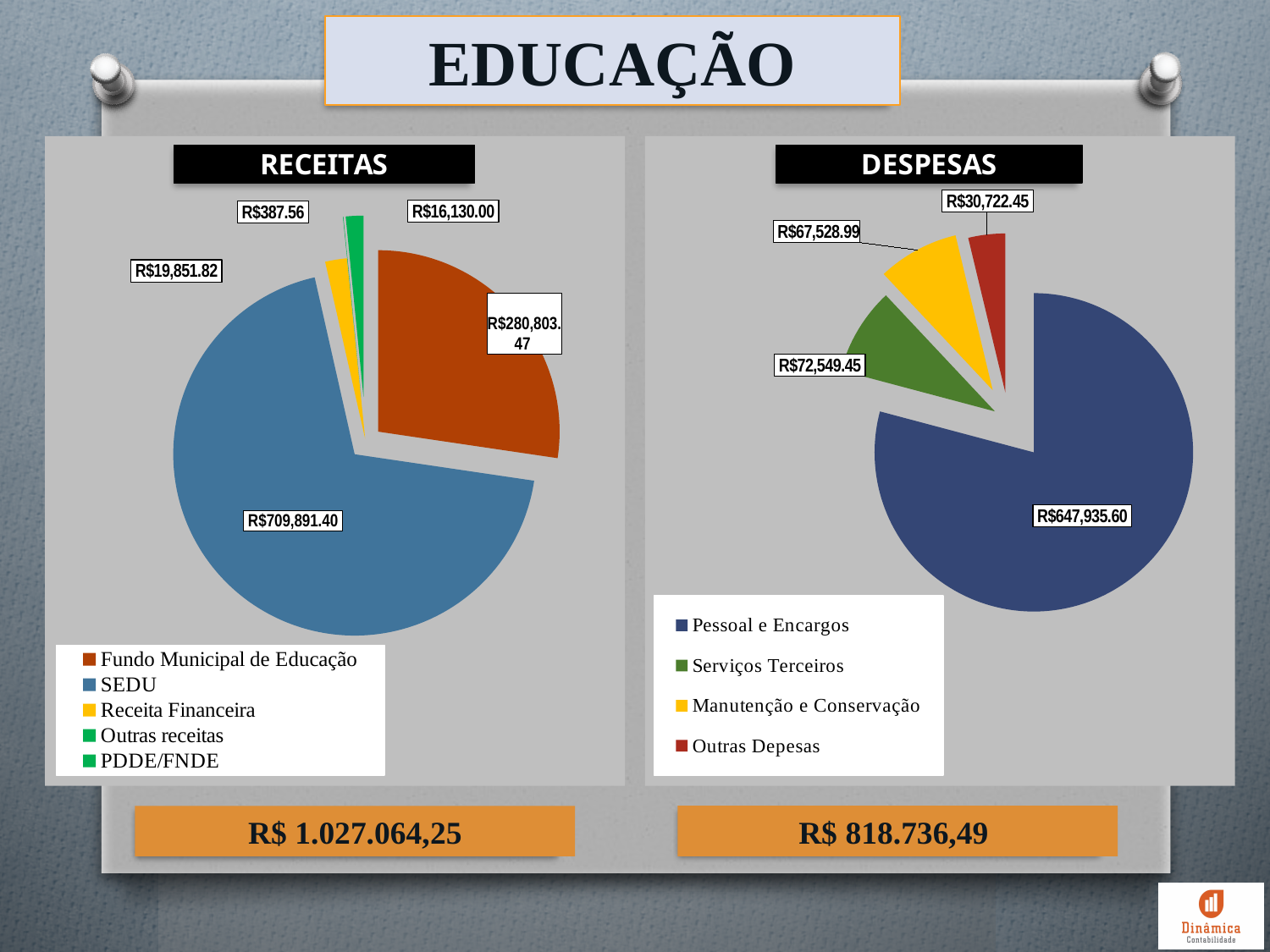
In the RECEITAS chart, how many categories does the legend list? 5 What type of chart is the RECEITAS chart? pie chart In the DESPESAS chart, which category has the smallest slice? Outras Depesas In the DESPESAS chart, what is the value for Serviços Terceiros? R$72,549.45 In the RECEITAS chart, what is the value for SEDU? R$709,891.40 In the DESPESAS chart, what is the difference between Serviços Terceiros and Manutenção e Conservação? R$5,020.46 In the RECEITAS chart, which category has the largest slice? SEDU In the DESPESAS chart, which is larger: Serviços Terceiros or Manutenção e Conservação? Serviços Terceiros In the RECEITAS chart, what is the value for Fundo Municipal de Educação? R$280,803.47 In the DESPESAS chart, what is the value for Pessoal e Encargos? R$647,935.60 In the RECEITAS chart, what is the value for Receita Financeira? R$19,851.82 In the RECEITAS chart, what is the difference between SEDU and Fundo Municipal de Educação? R$429,087.93